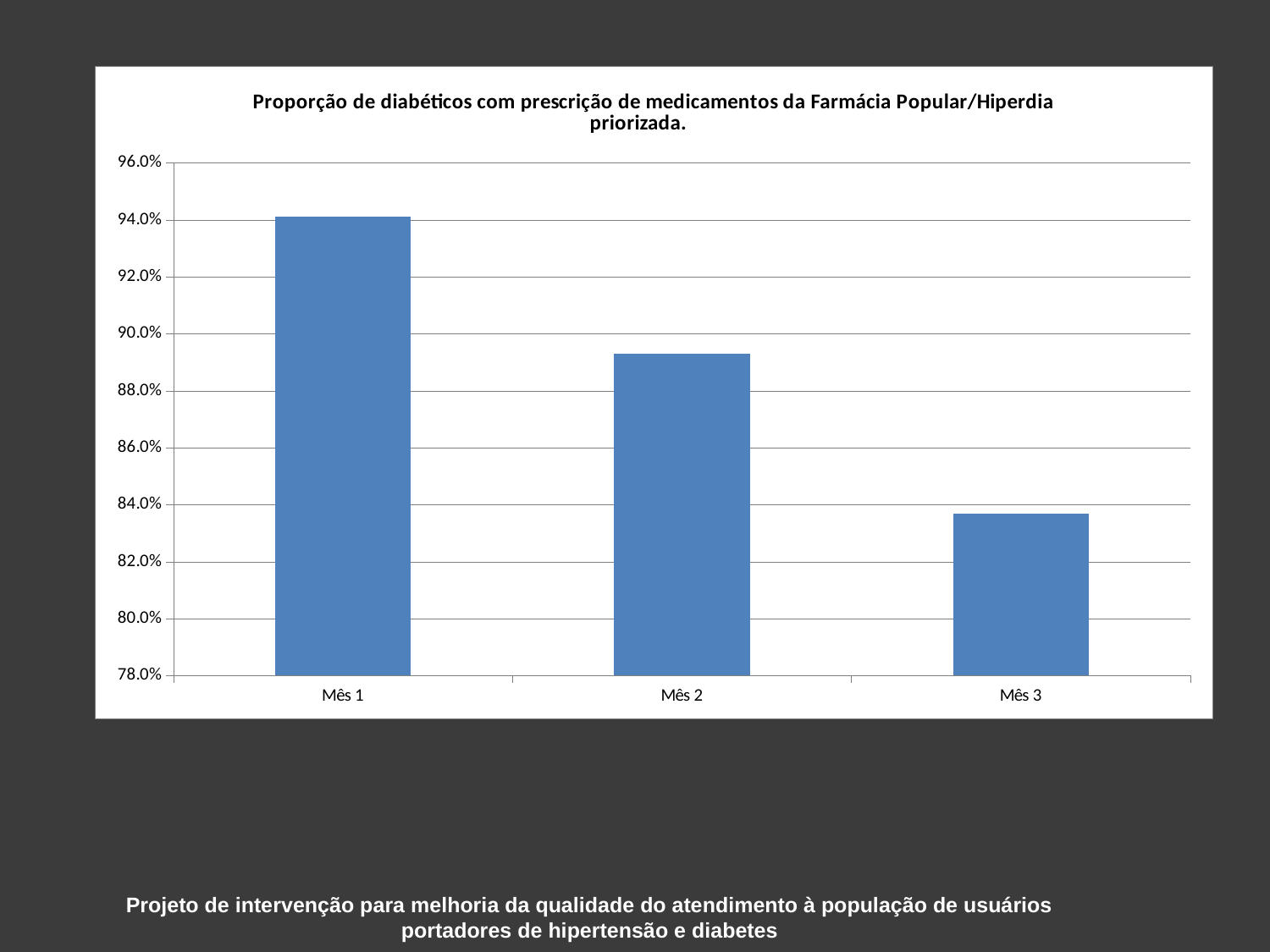
Which is larger, the value for Mês 2 or the value for Mês 3? Mês 2 Which month has the lowest proportion? Mês 3 Is the value for Mês 1 greater or less than 92.0%? greater Is the value for Mês 2 greater or less than 90.0%? less Which is larger, the value for Mês 1 or the value for Mês 2? Mês 1 Is the value for Mês 3 greater or less than 86.0%? less What is the title of the chart? Proporção de diabéticos com prescrição de medicamentos da Farmácia Popular/Hiperdia priorizada. How many categories (months) are plotted on the chart? 3 Which month has the highest proportion? Mês 1 Do the values rise or fall from Mês 1 to Mês 3? fall What kind of chart is shown on the slide? bar chart